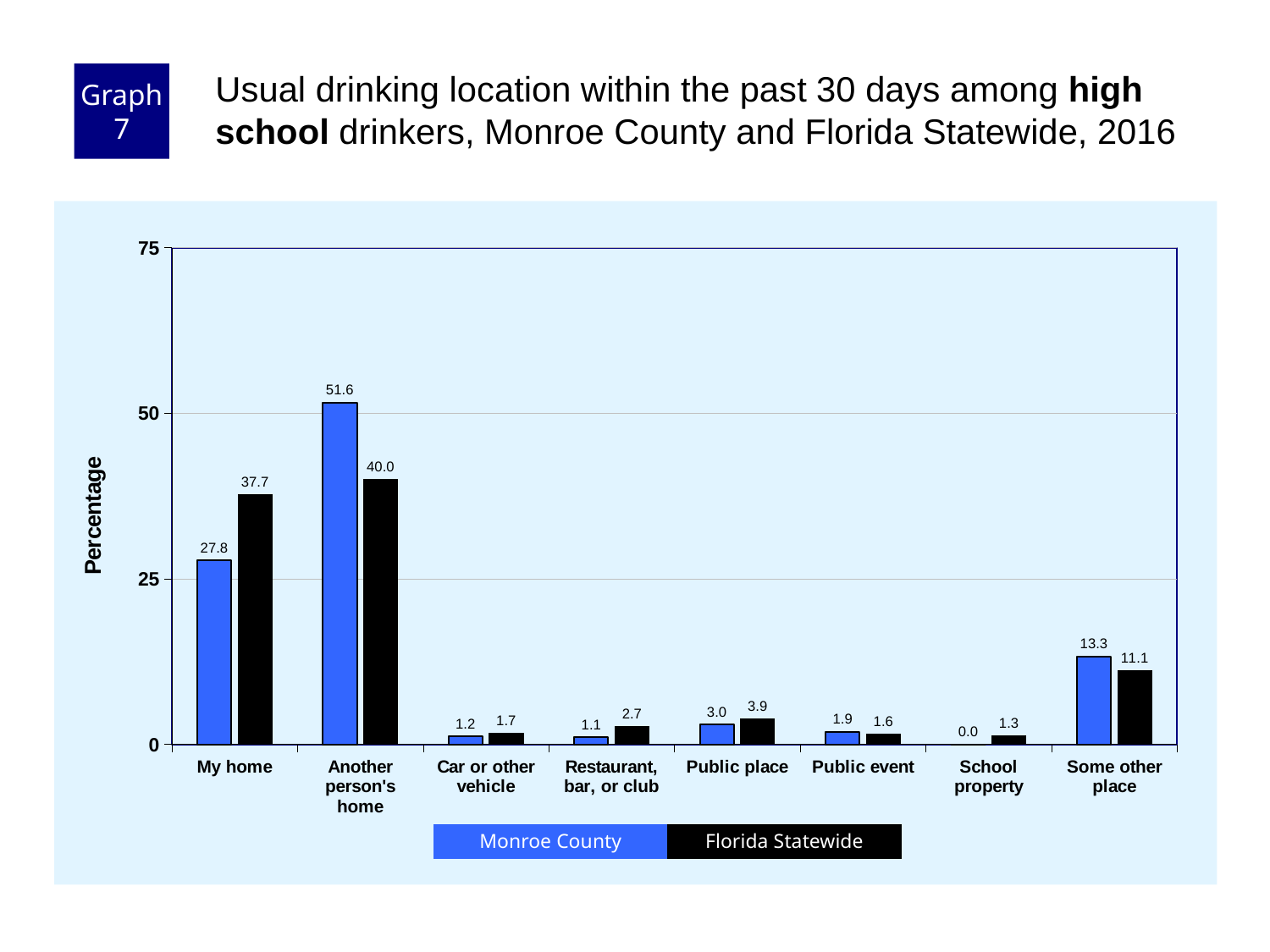
How many categories are shown on the x axis? 8 What is the Monroe County value for "Another person's home"? 51.6 What colour represents Florida Statewide in the chart? Black Which category has the highest Monroe County value? Another person's home What is the difference between the Monroe County and Florida Statewide values for "Another person's home"? 11.6 Which category has the lowest Florida Statewide value? School property Is the Monroe County value for "Another person's home" greater or less than 50? greater What is the Monroe County value for "School property"? 0.0 What kind of chart is shown on the slide? Bar chart What is the Florida Statewide value for "My home"? 37.7 How many series does the legend list? 2 For "Public place", which is larger: Monroe County or Florida Statewide? Florida Statewide